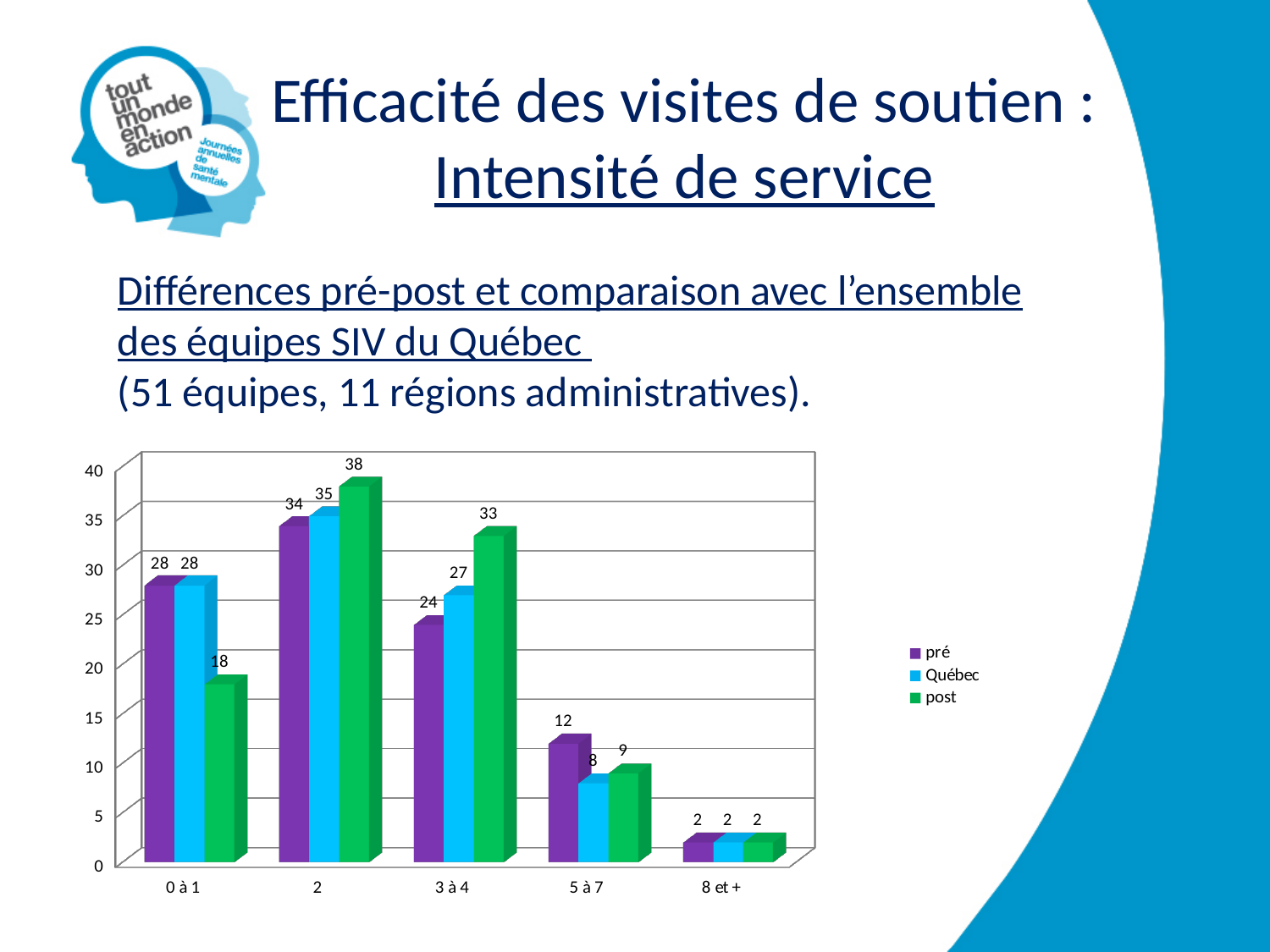
Which category has the highest 'post' value? 2 Which is larger in the '0 à 1' category: the 'pré' value or the 'post' value? pré How many categories are shown on the x axis? 5 What is the value for 'post' in the '0 à 1' category? 18 What are the three series listed in the legend? pré, Québec, post What is the value for 'Québec' in the '3 à 4' category? 27 What is the value for 'pré' in the '5 à 7' category? 12 How many series does the legend list? 3 Which category has the lowest 'pré' value? 8 et + Do the 'Québec' values rise or fall from the '2' category to the '8 et +' category? fall What kind of chart is shown on the slide? bar chart What is the difference between the 'post' and 'pré' values in the '3 à 4' category? 9